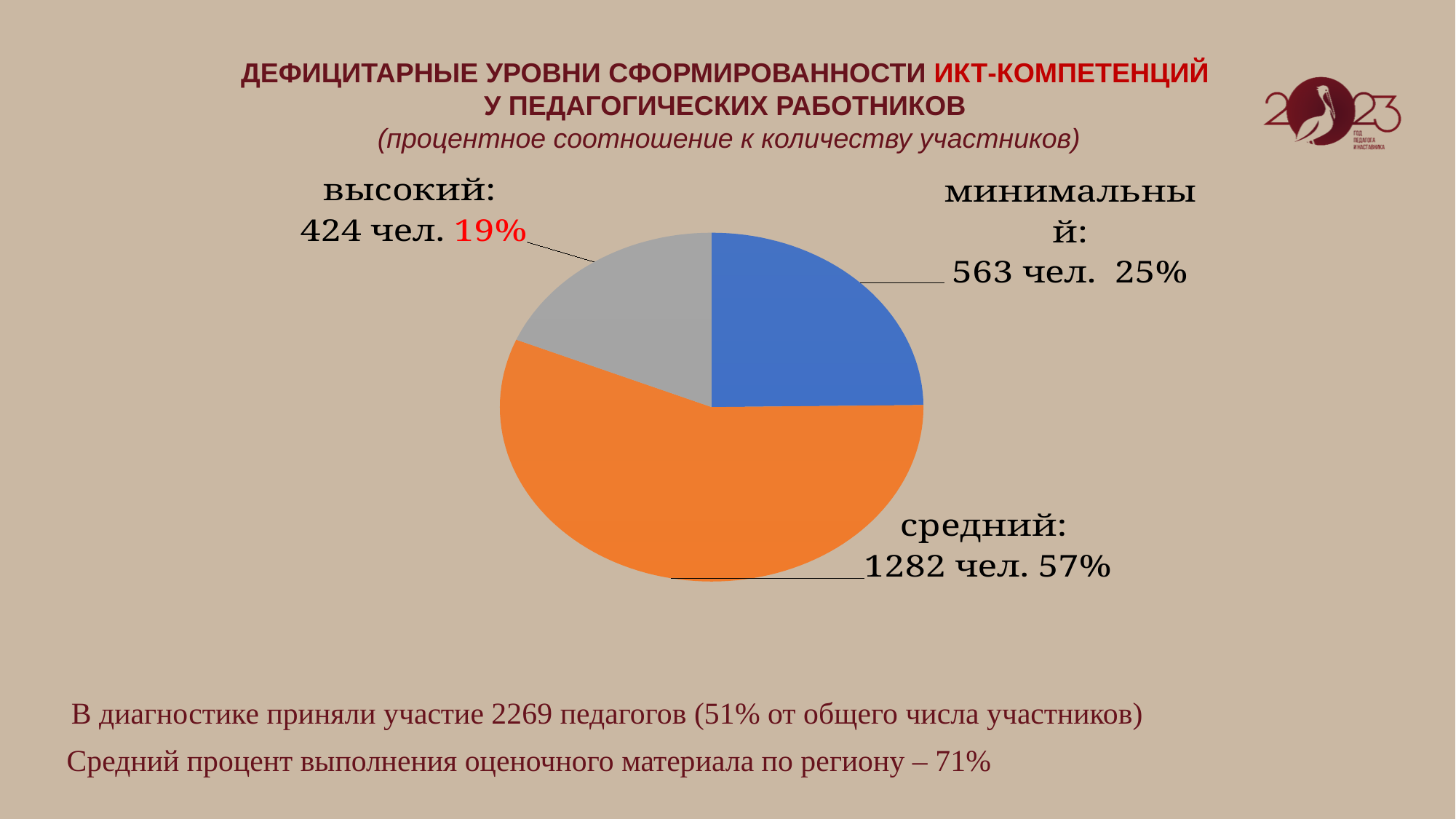
What percentage share does the "средний" slice have? 57% What percentage share does the "минимальный" slice have? 25% How many slices does the pie chart have? 3 What percentage share does the "высокий" slice have? 19% Which colour is the "средний" slice of the pie? orange What is the difference in number of people between the "минимальный" and "высокий" categories? 139 Which category has the smallest slice of the pie? высокий How many people (чел.) are in the "средний" category? 1282 чел. How many people (чел.) are in the "минимальный" category? 563 чел. Which category has the largest slice of the pie? средний What kind of chart is shown on the slide? pie chart How many people (чел.) are in the "высокий" category? 424 чел.